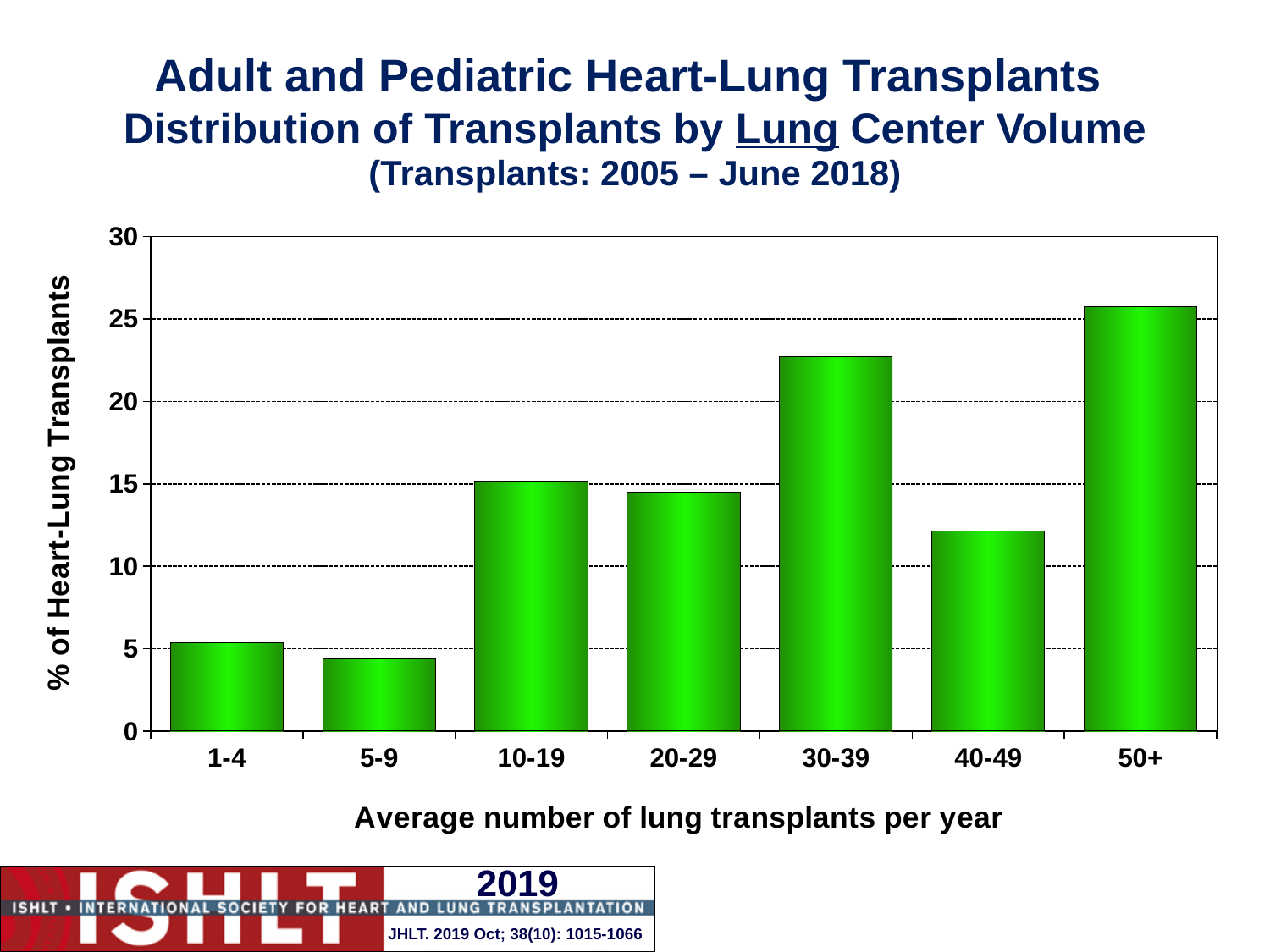
How many center volume categories are shown on the x axis? 7 What is the label of the x axis? Average number of lung transplants per year Is the value for the 40-49 category greater or less than 10? greater Is the value for the 50+ category greater or less than 25? greater Which center volume category has the lowest percentage of heart-lung transplants? 5-9 Which has a higher percentage of heart-lung transplants, the 30-39 category or the 40-49 category? 30-39 What is the label of the y axis? % of Heart-Lung Transplants Which center volume category has the highest percentage of heart-lung transplants? 50+ Is the value for the 20-29 category greater or less than 15? less What kind of chart is shown on the slide? bar chart